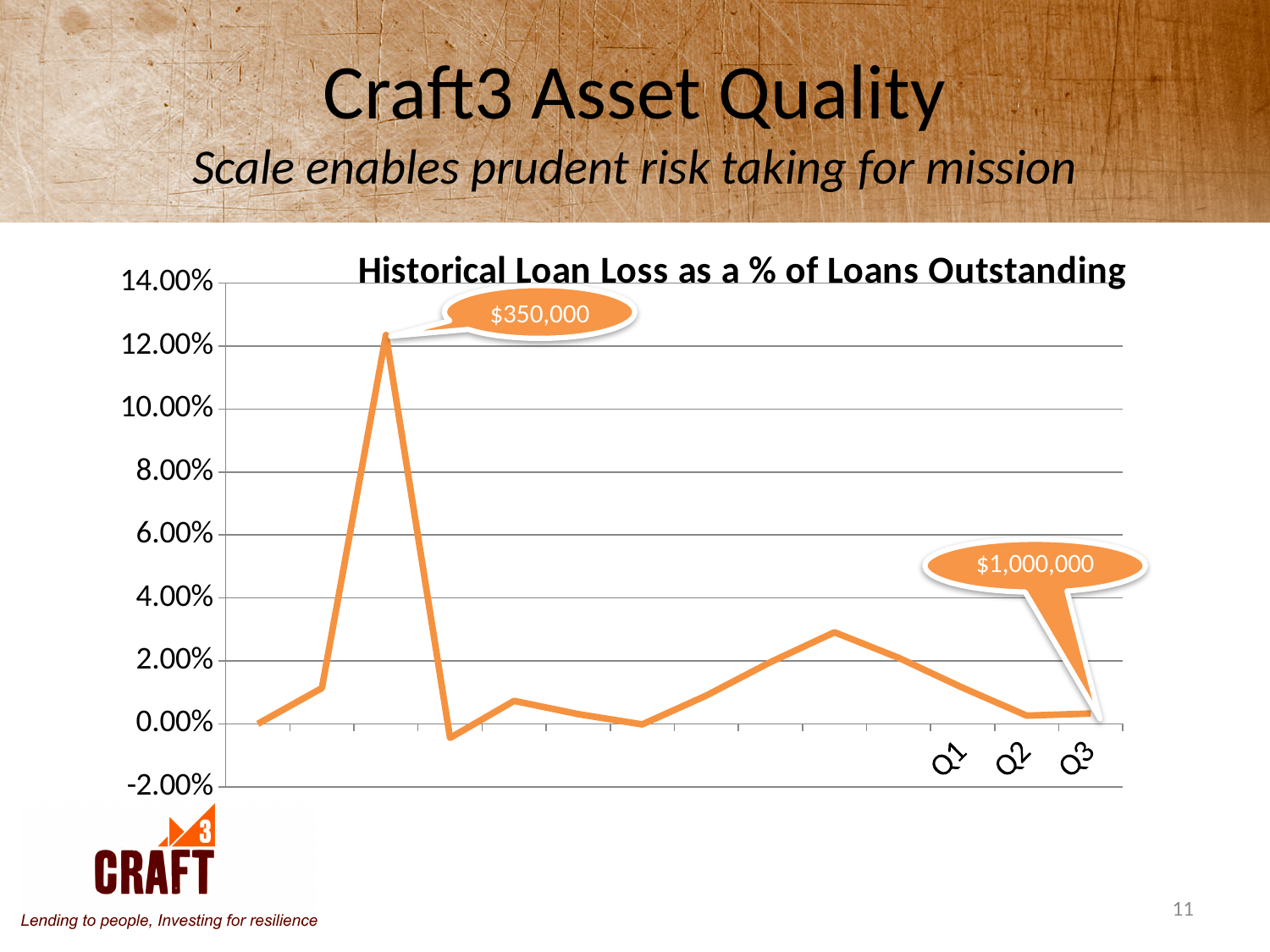
What type of chart is shown on the slide? line chart What is the title of the chart? Historical Loan Loss as a % of Loans Outstanding Is the peak value of the line greater or less than 14.00%? less Is the peak value of the line greater or less than 12.00%? greater What is the highest value shown on the y axis? 14.00% What dollar amount is shown in the callout pointing to Q3? $1,000,000 Is the value for Q3 greater or less than 2.00%? less Which is larger, the value for Q1 or the value for Q2? Q1 Does the line rise or fall from Q1 to Q2? fall What dollar amount is shown in the callout pointing to the peak of the line? $350,000